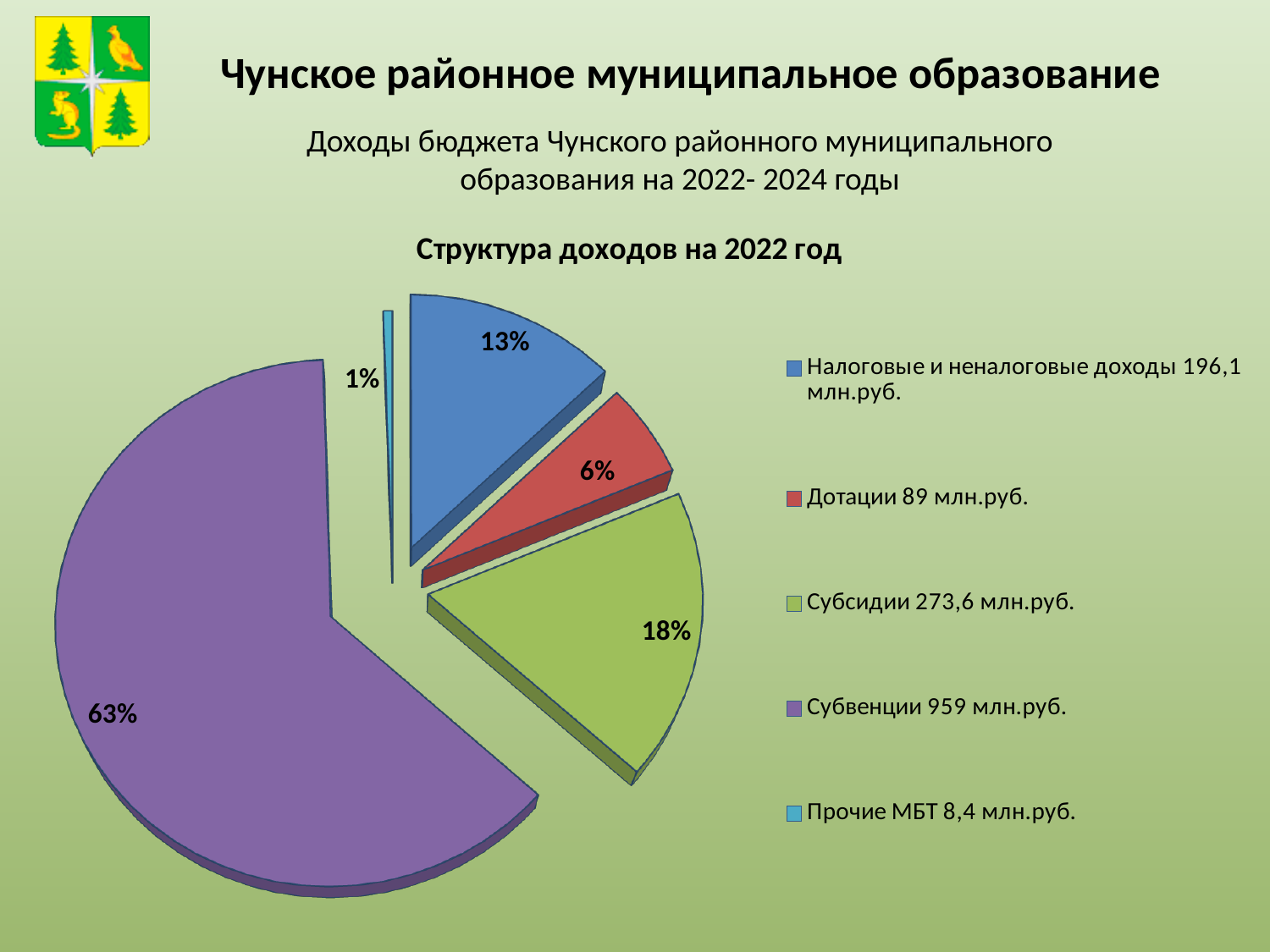
What share of the pie is labelled for Субвенции? 63% What is the title of the chart? Структура доходов на 2022 год Which category has the smallest slice of the pie? Прочие МБТ What is the difference in percentage points between the Субвенции slice and the Субсидии slice? 45% What share of the pie is labelled for Налоговые и неналоговые доходы? 13% What share of the pie is labelled for Прочие МБТ? 1% What kind of chart is shown on the slide? pie chart Which category has the largest slice of the pie? Субвенции Which slice is larger: Субсидии or Дотации? Субсидии How many slices does the pie chart have? 5